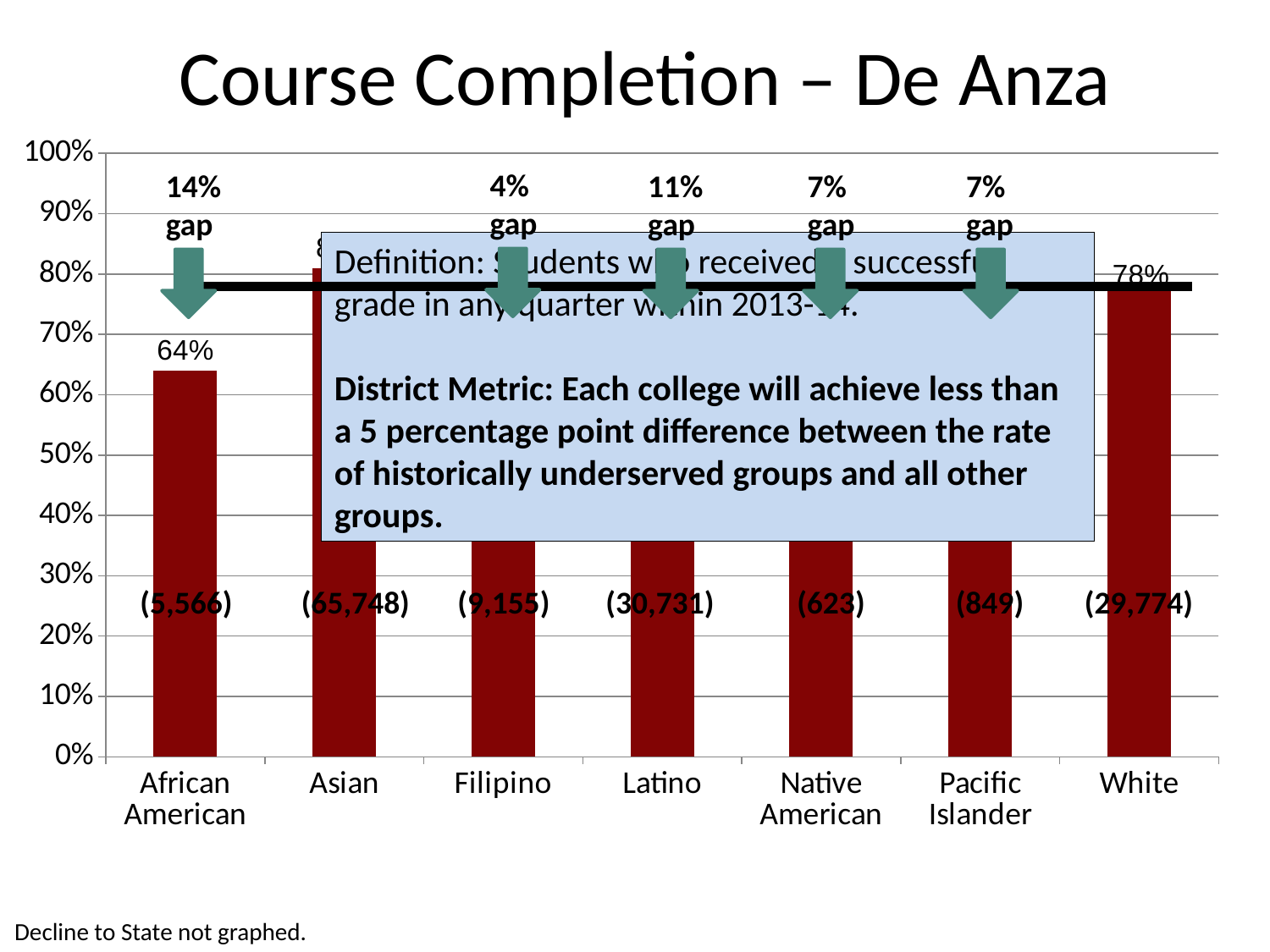
Is the value for African American greater or less than 70%? less What is the course completion rate for African American students? 64% Is the value for Asian greater or less than 70%? greater What gap is labeled above the African American bar? 14% gap Which is larger, the completion rate for White students or for African American students? White What is the difference between the course completion rates for White and African American students? 14% What kind of chart is shown on the slide? bar chart How many ethnic groups are shown on the x axis of the chart? 7 Is the value for White greater or less than 70%? greater What gap is labeled above the Latino bar? 11% gap What number in parentheses is shown on the Asian bar? (65,748) What is the course completion rate for White students? 78%